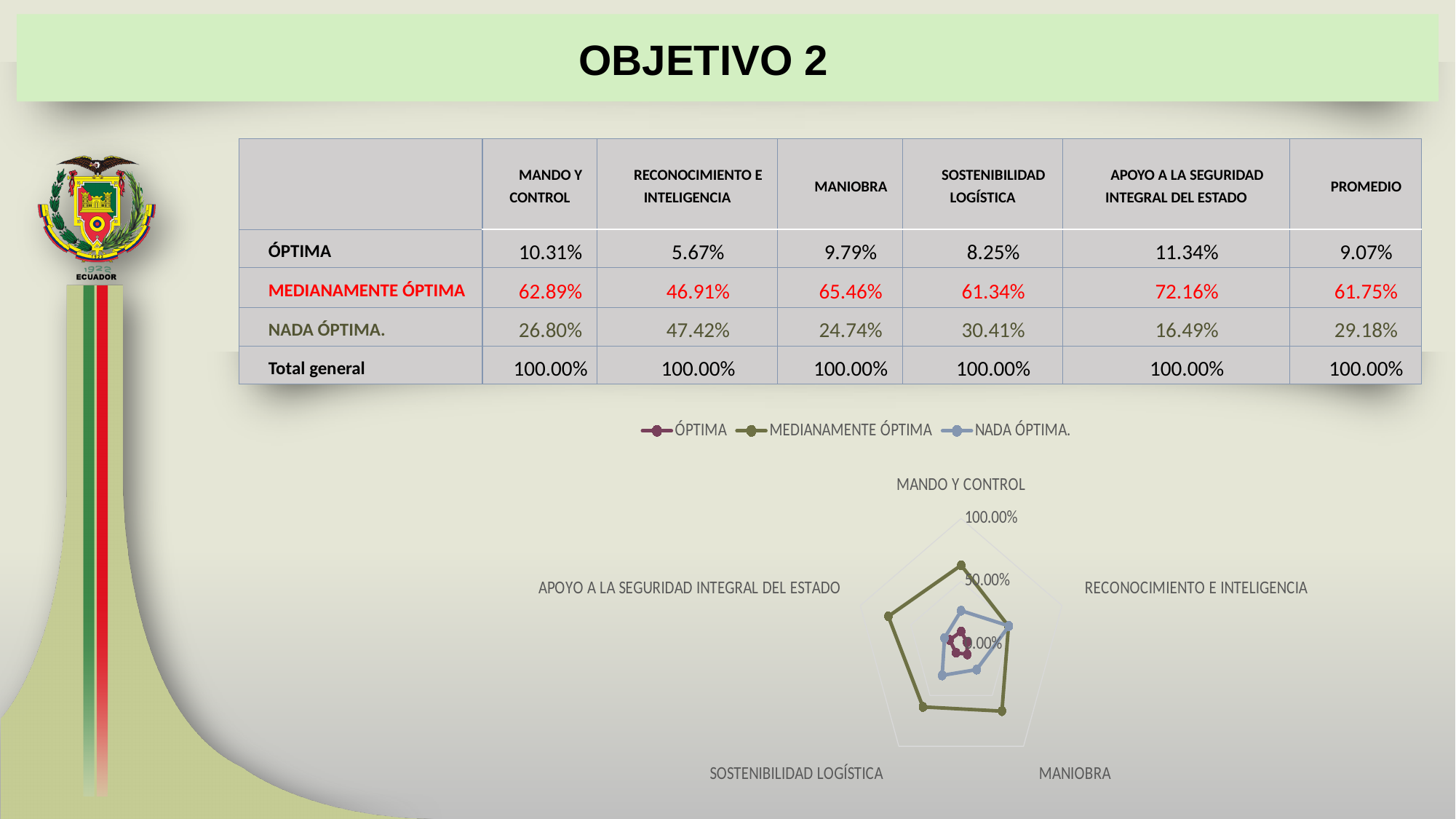
How many categories (axes) does the radar chart have? 5 What kind of chart is shown on the slide? Radar chart For which category is the MEDIANAMENTE ÓPTIMA value the lowest? RECONOCIMIENTO E INTELIGENCIA How many series does the chart legend list? 3 Which is larger at MANIOBRA: the MEDIANAMENTE ÓPTIMA value or the NADA ÓPTIMA. value? MEDIANAMENTE ÓPTIMA What is the value for NADA ÓPTIMA. at RECONOCIMIENTO E INTELIGENCIA? 47.42% Which series is plotted in the outermost position on the radar chart? MEDIANAMENTE ÓPTIMA Is the value for NADA ÓPTIMA. at RECONOCIMIENTO E INTELIGENCIA greater or less than 50.00%? less What is the value for MEDIANAMENTE ÓPTIMA at APOYO A LA SEGURIDAD INTEGRAL DEL ESTADO? 72.16% Is the value for MEDIANAMENTE ÓPTIMA at APOYO A LA SEGURIDAD INTEGRAL DEL ESTADO greater or less than 50.00%? greater For which category is the MEDIANAMENTE ÓPTIMA value the highest? APOYO A LA SEGURIDAD INTEGRAL DEL ESTADO Is the value for ÓPTIMA at MANDO Y CONTROL greater or less than 50.00%? less